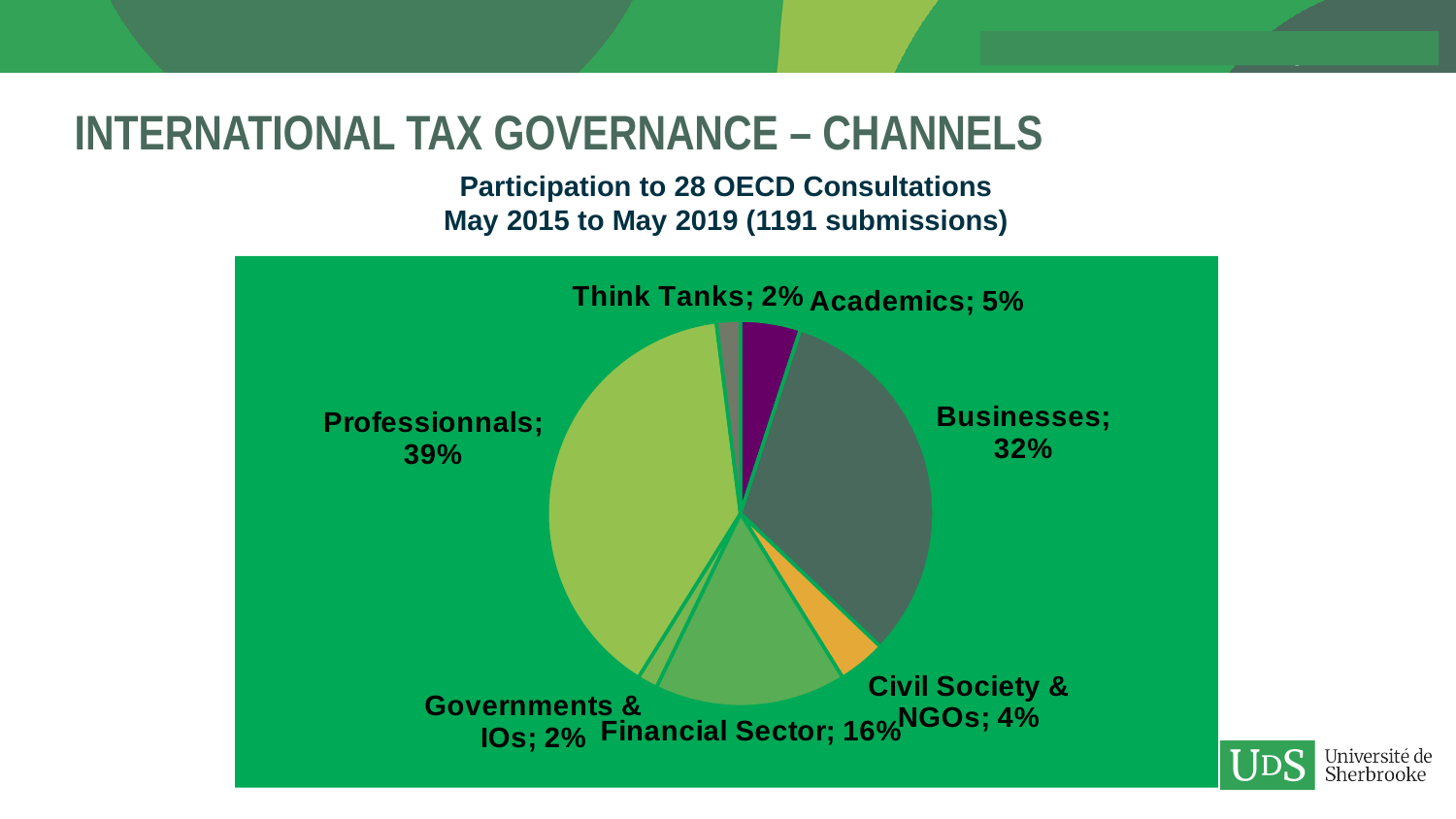
How many submissions does the chart title say were included? 1191 What share of submissions came from Businesses? 32% What share of submissions came from Civil Society & NGOs? 4% What is the combined share of Think Tanks and Governments & IOs? 4% What is the difference in percentage points between Professionnals and Businesses? 7 Which category has the largest share of the pie? Professionnals What kind of chart is shown on the slide? Pie chart Which is larger, the share for Financial Sector or the share for Academics? Financial Sector What share of submissions came from the Financial Sector? 16% What share of submissions came from Professionnals? 39% What share of submissions came from Academics? 5% How many categories are shown in the pie chart? 7